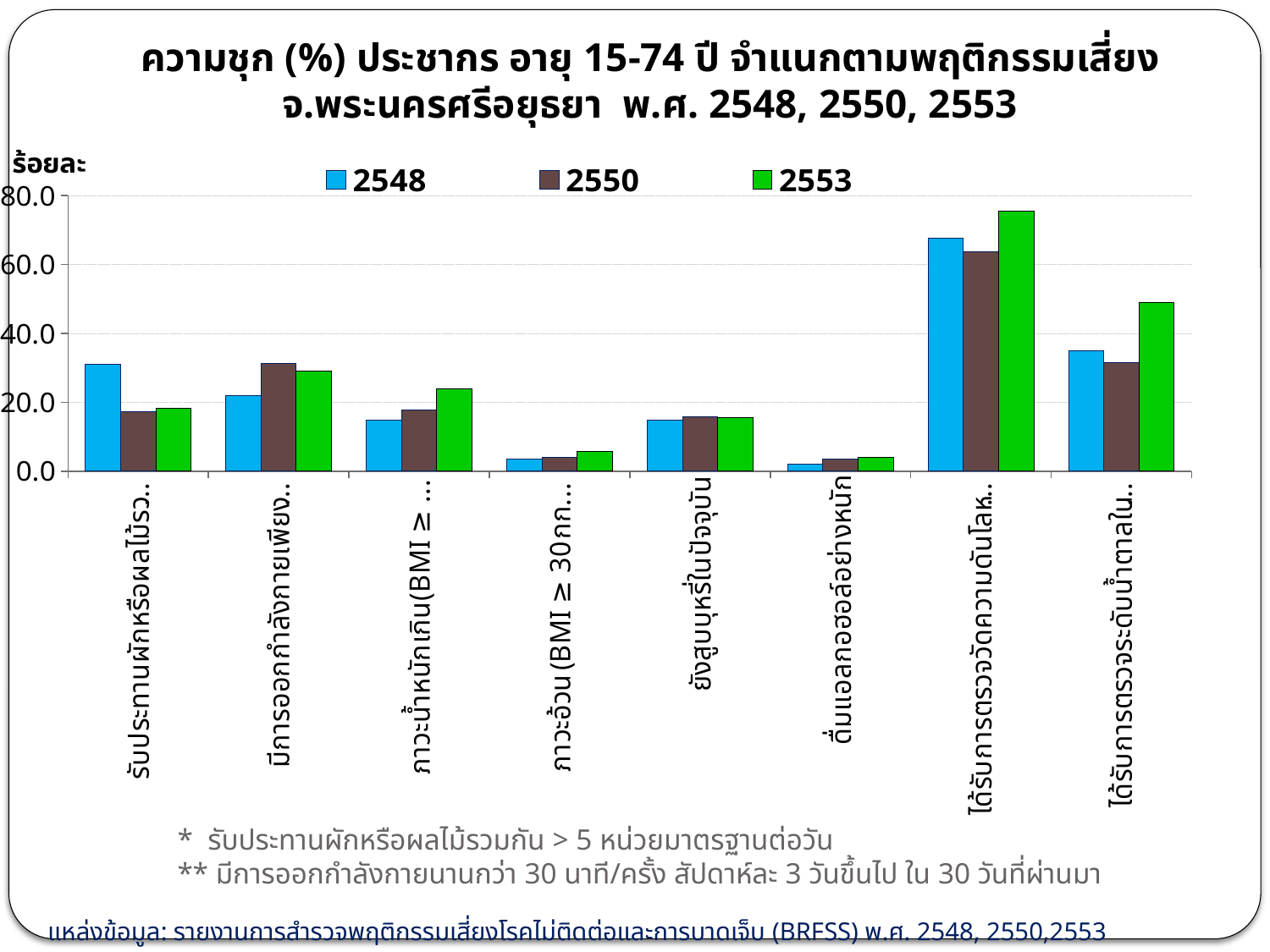
What kind of chart is shown on the slide? bar chart Which years are listed in the legend? 2548, 2550, 2553 For the first category (รับประทานผักหรือผลไม้...), which year has the larger value, 2548 or 2553? 2548 How many series does the legend list? 3 Is the 2553 value for the last category (ได้รับการตรวจวัดระดับน้ำตาลใน...) greater or less than 40? greater How many risk-behaviour categories are plotted along the x axis? 8 Is the 2548 value for ดื่มแอลกอฮอล์อย่างหนัก greater or less than 20? less Which colour represents the year 2553 in the chart? green Is the 2553 value for ได้รับการตรวจวัดความดันโลหิต (the seventh category) greater or less than 60? greater Which category has the lowest 2548 value? ดื่มแอลกอฮอล์อย่างหนัก Which category has the highest 2553 value? ได้รับการตรวจวัดความดันโลหิต (the seventh category) For ภาวะน้ำหนักเกิน (BMI ≥ ...), the third category, do the values rise or fall from 2548 to 2553? rise